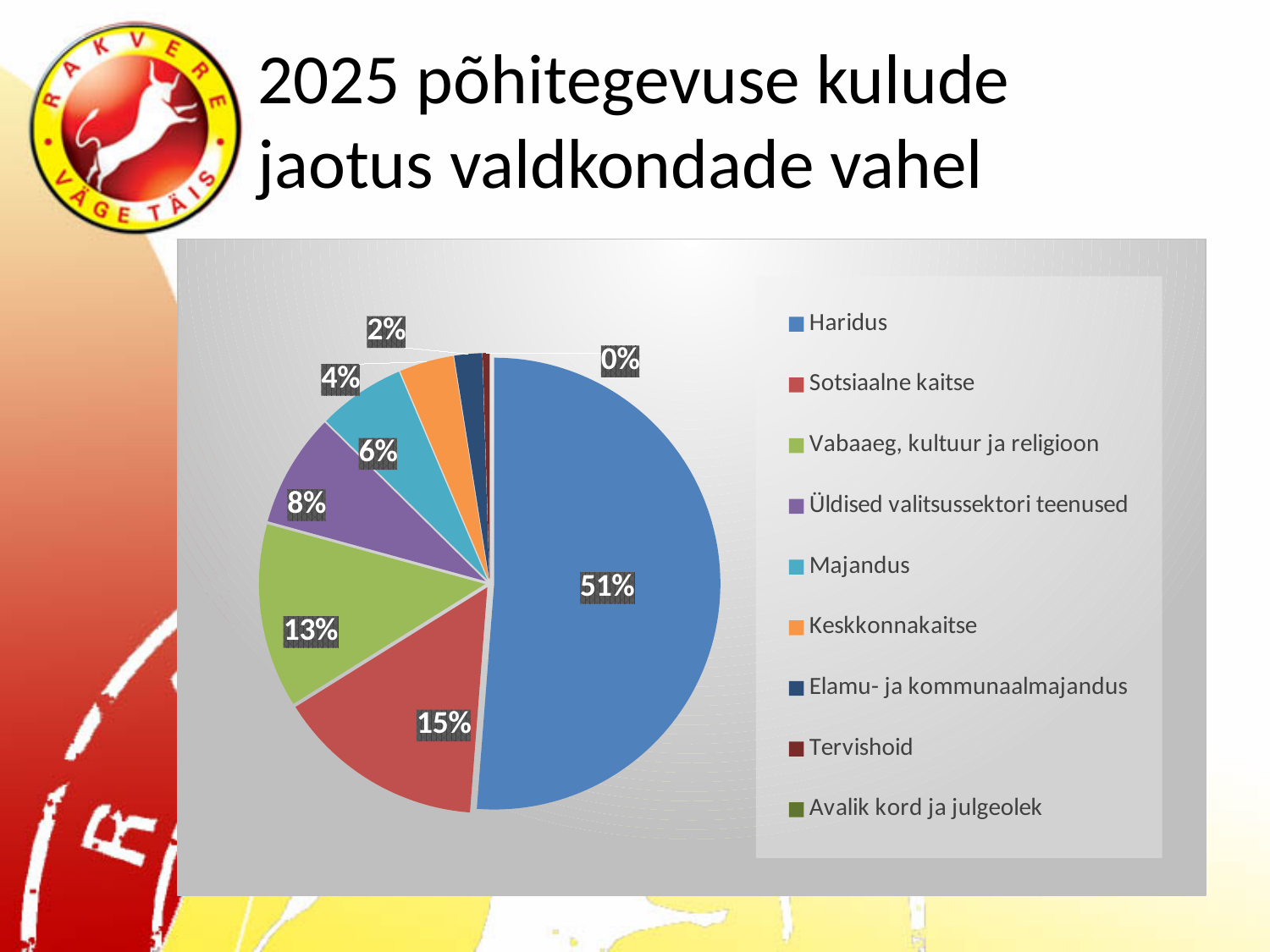
What share of the pie does Sotsiaalne kaitse have? 15% What share of the pie does Vabaaeg, kultuur ja religioon have? 13% Which category has the largest slice of the pie? Haridus What share of the pie does Majandus have? 6% What share of the pie does Üldised valitsussektori teenused have? 8% What share of the pie does Elamu- ja kommunaalmajandus have? 2% How many categories does the legend list? 9 What kind of chart is shown on the slide? pie chart How many percentage points larger is the Haridus slice than the Sotsiaalne kaitse slice? 36 What share of the pie does Haridus have? 51% What share of the pie does Keskkonnakaitse have? 4% Which slice is larger: Vabaaeg, kultuur ja religioon or Üldised valitsussektori teenused? Vabaaeg, kultuur ja religioon